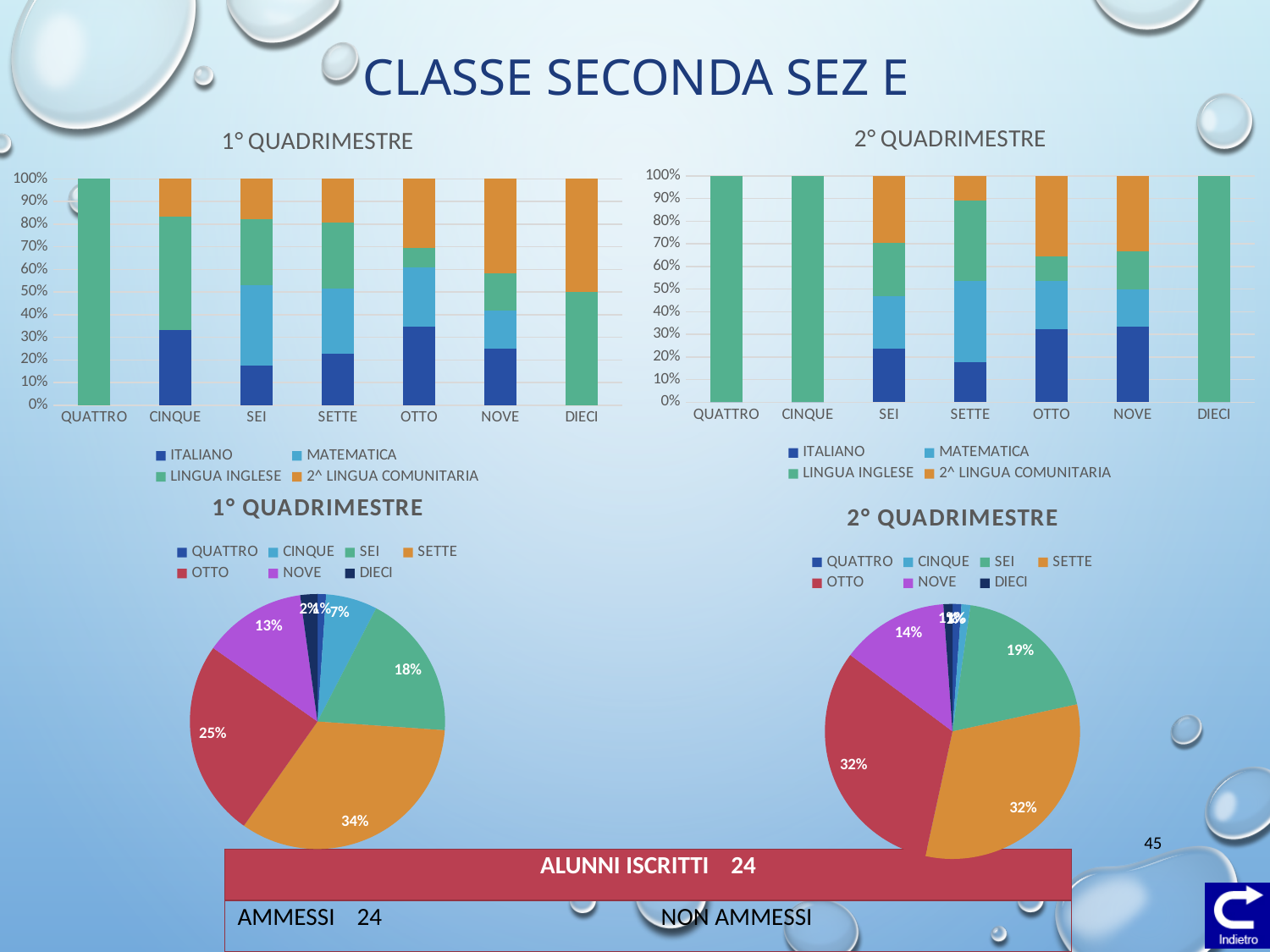
How many series does the legend of the 1° Quadrimestre stacked bar chart (top left) list? 4 What kind of chart is the 2° Quadrimestre chart at the bottom right of the slide? Pie chart In the 1° Quadrimestre pie chart, which is larger, the share for SEI or the share for CINQUE? SEI In the 1° Quadrimestre pie chart, what share does SETTE have? 34% In the 1° Quadrimestre pie chart, what share does OTTO have? 25% In the 2° Quadrimestre stacked bar chart (top right), is the ITALIANO value for NOVE greater or less than 30%? greater In the 2° Quadrimestre pie chart, what share does NOVE have? 14% In the 1° Quadrimestre pie chart, which category has the largest slice? SETTE In the 1° Quadrimestre stacked bar chart (top left), is the ITALIANO value for SEI greater or less than 20%? less How many categories are shown on the x axis of the 2° Quadrimestre stacked bar chart (top right)? 7 In the 1° Quadrimestre pie chart, what is the difference between the SEI and NOVE shares? 5%